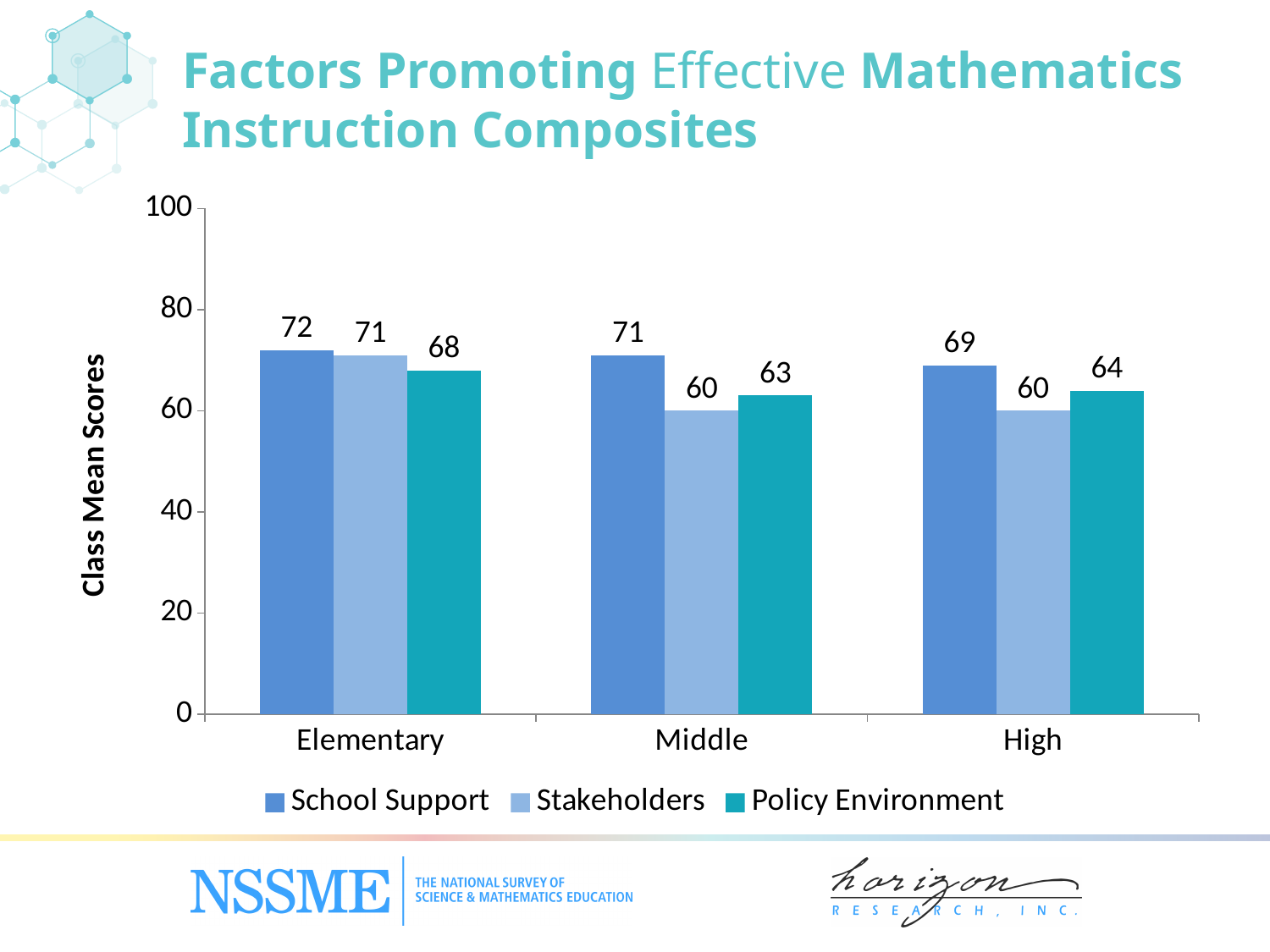
What is the Policy Environment value for High? 64 Which is larger for High: the Stakeholders value or the Policy Environment value? Policy Environment What is the label of the y axis? Class Mean Scores Which grade level has the lowest Policy Environment value? Middle How many grade-level categories are shown on the x axis? 3 Is the Policy Environment value for Elementary greater or less than 60? greater What kind of chart is shown on the slide? Bar chart How many series does the legend list? 3 What is the Stakeholders value for Middle? 60 Which grade level has the highest School Support value? Elementary What is the School Support value for Elementary? 72 What is the difference between the School Support and Stakeholders values for Middle? 11